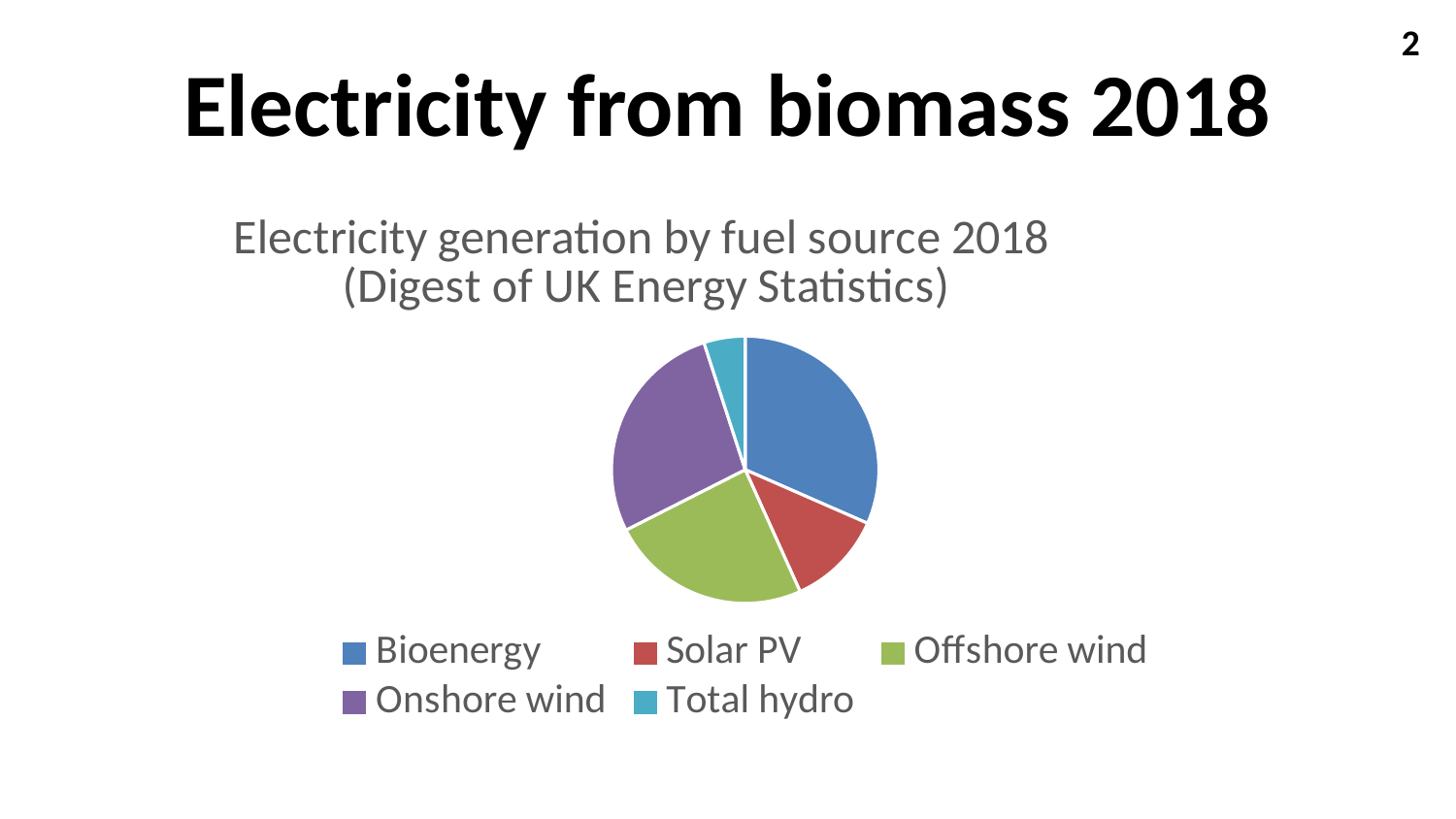
Which slice is larger, Bioenergy or Solar PV? Bioenergy Which slice is larger, Solar PV or Offshore wind? Offshore wind What kind of chart is shown on the slide? Pie chart Which slice is larger, Onshore wind or Total hydro? Onshore wind Which fuel source is shown in green in the pie chart? Offshore wind How many fuel sources (slices) does the pie chart show? 5 What is the title of the pie chart? Electricity generation by fuel source 2018 (Digest of UK Energy Statistics) Which fuel source has the smallest slice in the pie chart? Total hydro How many entries does the legend of the pie chart list? 5